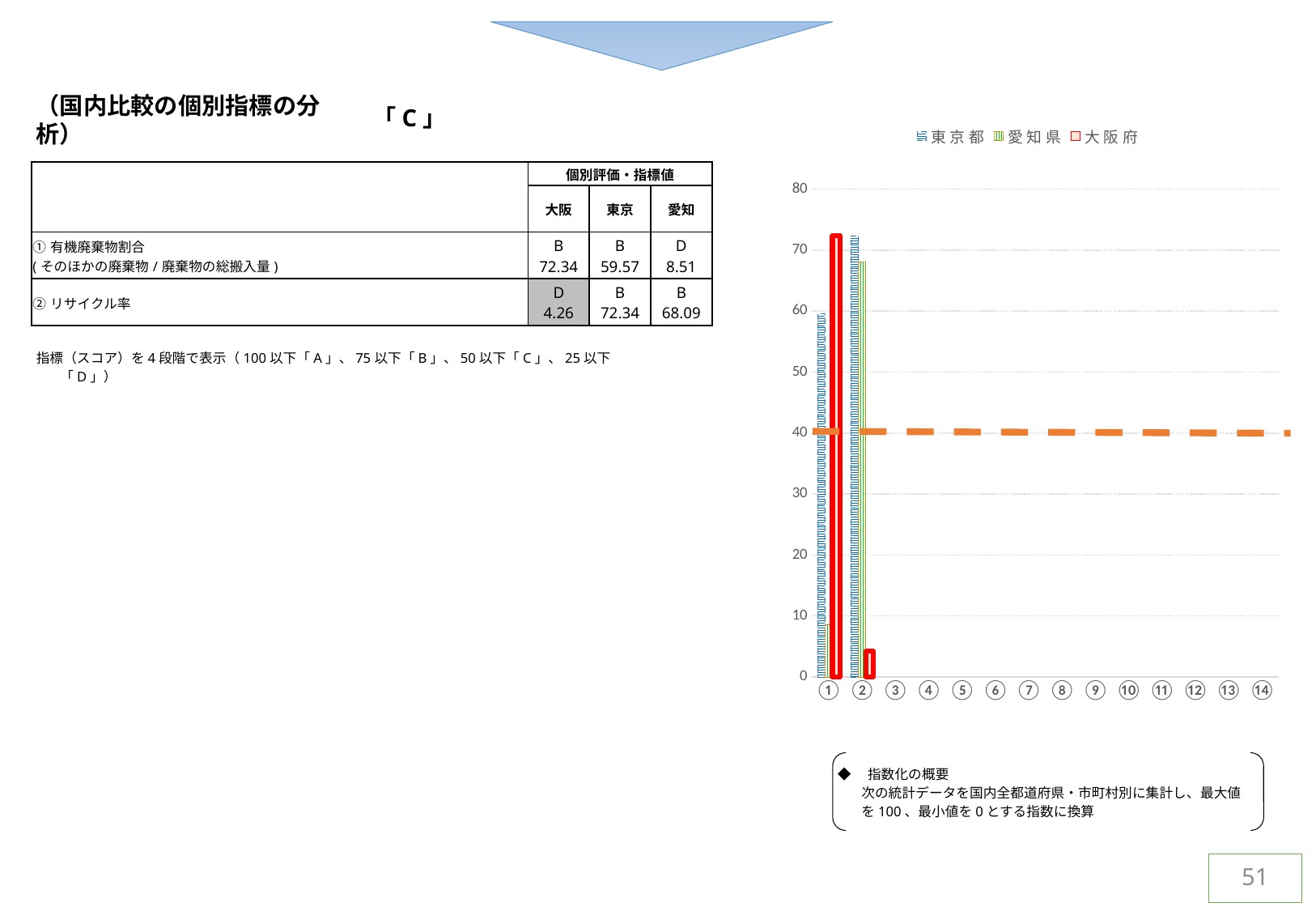
How many series does the chart legend list? 3 Which series has the shortest bar at category ②? 大阪府 Is the value for 東京都 at category ① greater or less than 50? greater Which series has the shortest bar at category ①? 愛知県 Is the value for 大阪府 at category ② greater or less than 10? less Which is larger: the 大阪府 bar at category ① or the 大阪府 bar at category ②? category ① At what level on the y axis is the dashed horizontal line drawn across the chart? 40 How many categories are shown along the x axis of the chart? 14 Is the value for 愛知県 at category ① greater or less than 20? less What kind of chart is shown on the right side of the slide? bar chart Which series has the tallest bar at category ①? 大阪府